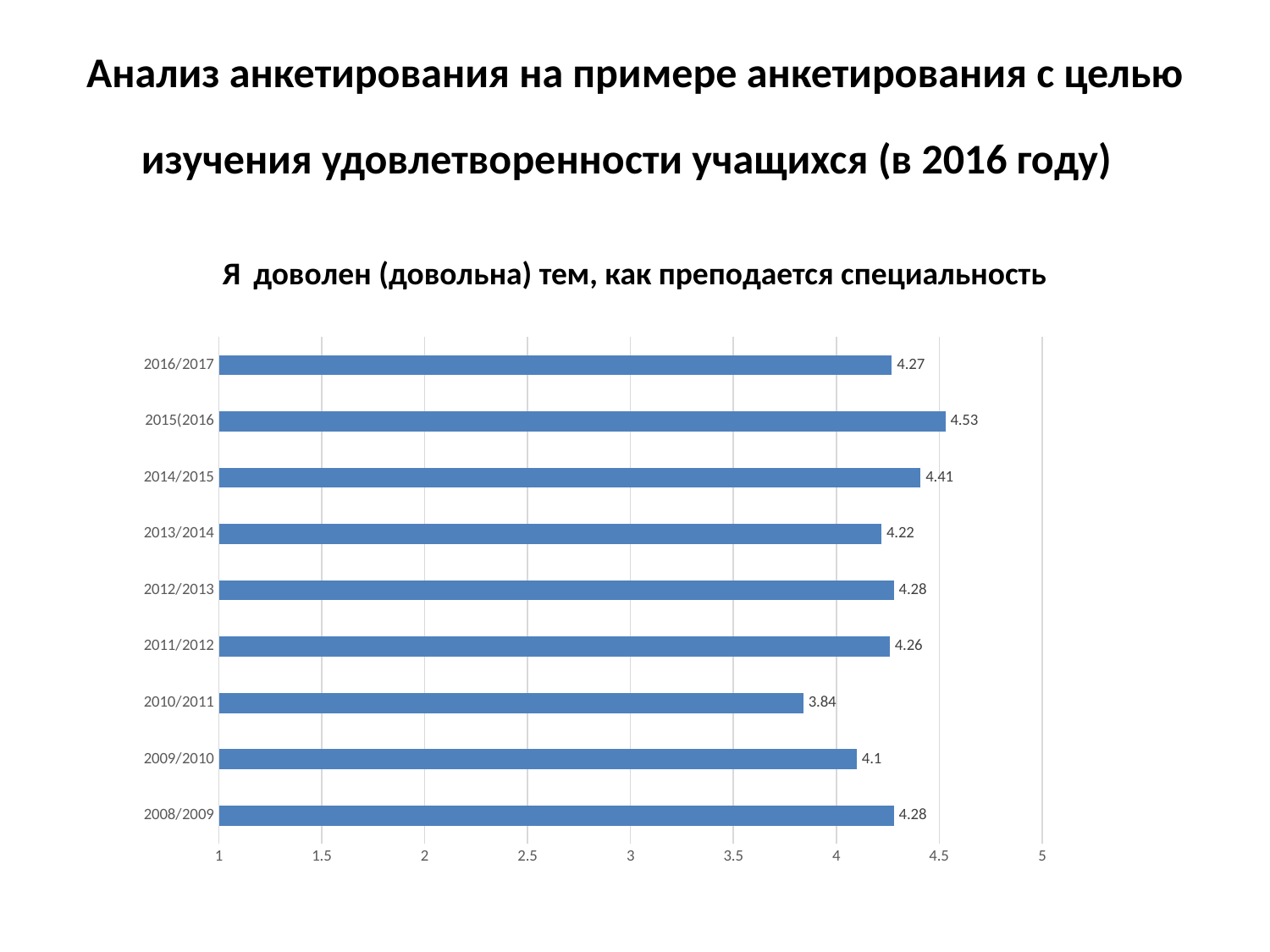
What is the difference between the values for 2015(2016 and 2014/2015? 0.12 Which academic year has the lowest value? 2010/2011 Is the value for 2010/2011 greater or less than 4? less How many academic years are shown on the chart? 9 What is the title of the chart? Я доволен (довольна) тем, как преподается специальность What kind of chart is shown on the slide? bar chart What is the difference between the values for 2016/2017 and 2010/2011? 0.43 What is the value for 2010/2011? 3.84 Which academic year has the highest value? 2015(2016 What is the value for 2016/2017? 4.27 Which is larger, the value for 2014/2015 or the value for 2013/2014? 2014/2015 What is the value for 2009/2010? 4.1